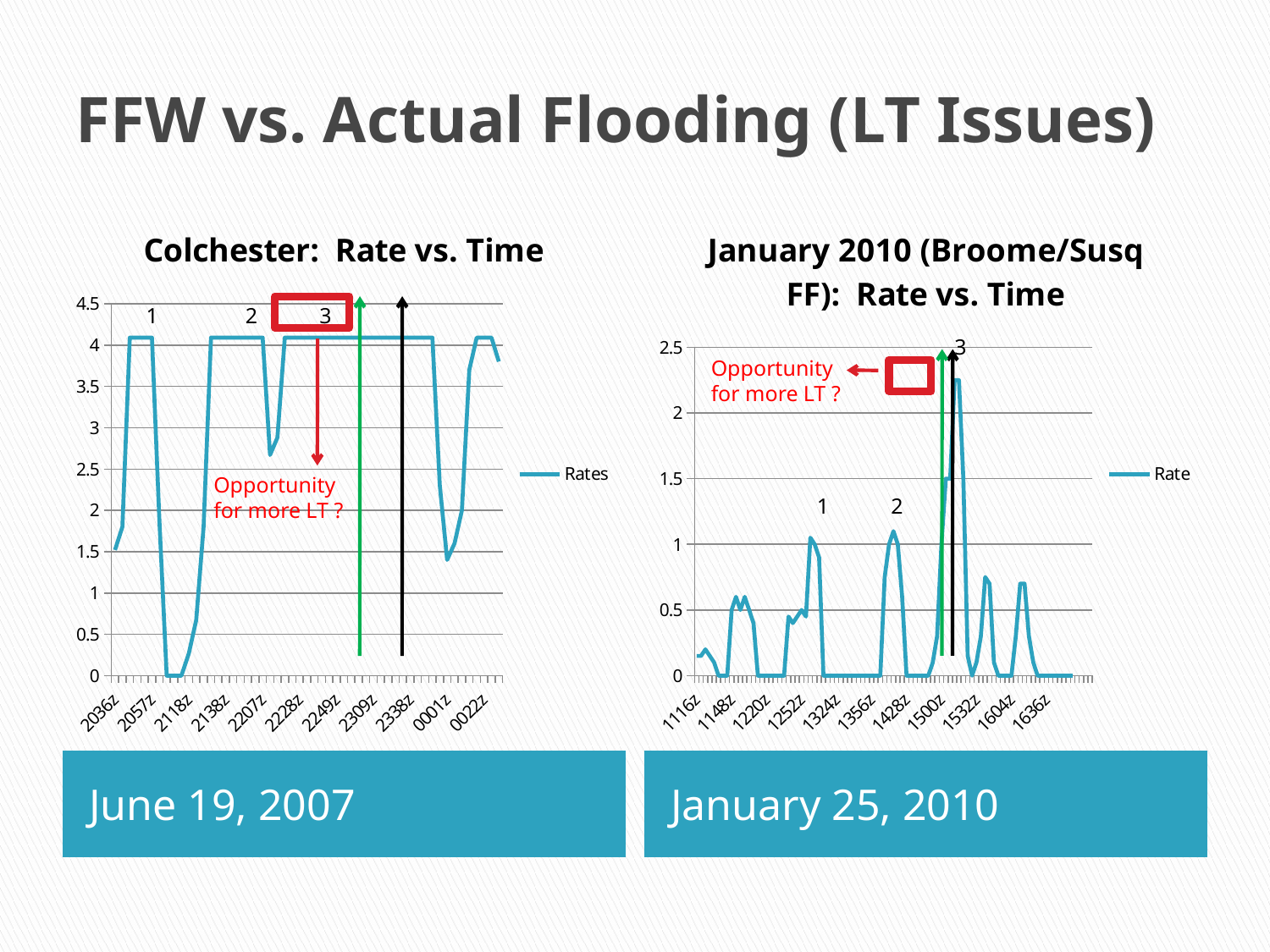
In the right chart ('January 2010 (Broome/Susq FF): Rate vs. Time'), is the highest value reached by the line greater or less than 2? greater In the left chart ('Colchester: Rate vs. Time'), is the value at 2118z greater or less than 1? less What kind of chart is the 'Colchester: Rate vs. Time' chart on the left? line chart How many series does the legend of the left chart ('Colchester: Rate vs. Time') list? 1 What is the name of the series in the legend of the right chart ('January 2010 (Broome/Susq FF): Rate vs. Time')? Rate What kind of chart is the 'January 2010 (Broome/Susq FF): Rate vs. Time' chart on the right? line chart In the left chart ('Colchester: Rate vs. Time'), which is larger, the value at 2057z or the value at 2118z? 2057z In the left chart ('Colchester: Rate vs. Time'), is the value at 2057z greater or less than 3? greater What is the name of the series in the legend of the left chart ('Colchester: Rate vs. Time')? Rates In the right chart ('January 2010 (Broome/Susq FF): Rate vs. Time'), which is larger, the value at 1252z or the value at 1356z? 1252z